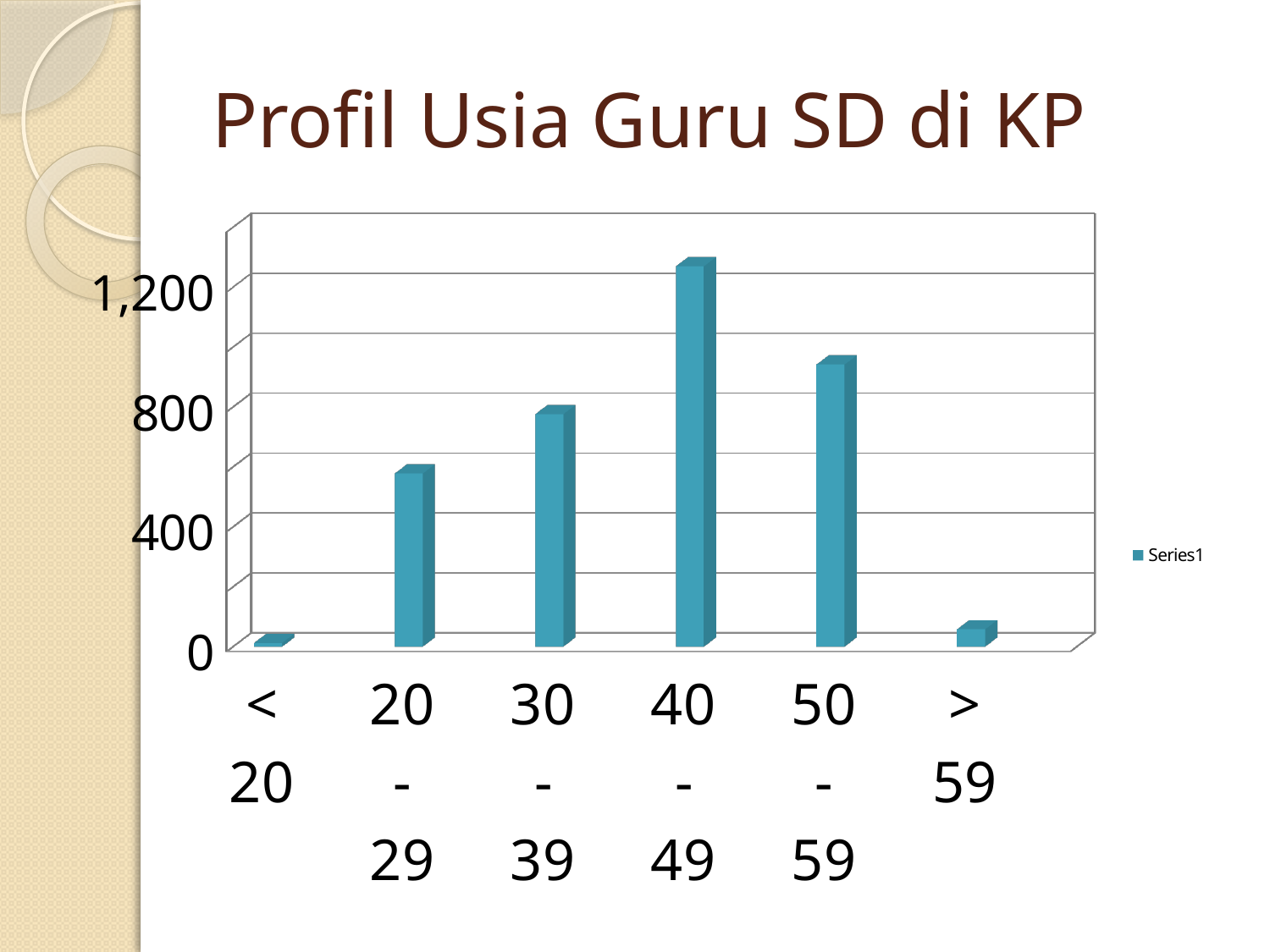
What type of chart is shown on the slide? bar chart Which is larger, the value for 50 - 59 or the value for 30 - 39? 50 - 59 Is the value for > 59 greater or less than 400? less Which is larger, the value for 20 - 29 or the value for > 59? 20 - 29 Is the value for 40 - 49 greater or less than 1,200? greater Which age category has the highest value? 40 - 49 Is the value for 20 - 29 greater or less than 400? greater What is the title of the chart? Profil Usia Guru SD di KP How many age categories are shown on the x axis? 6 How many series does the legend list? 1 Which age category has the lowest value? < 20